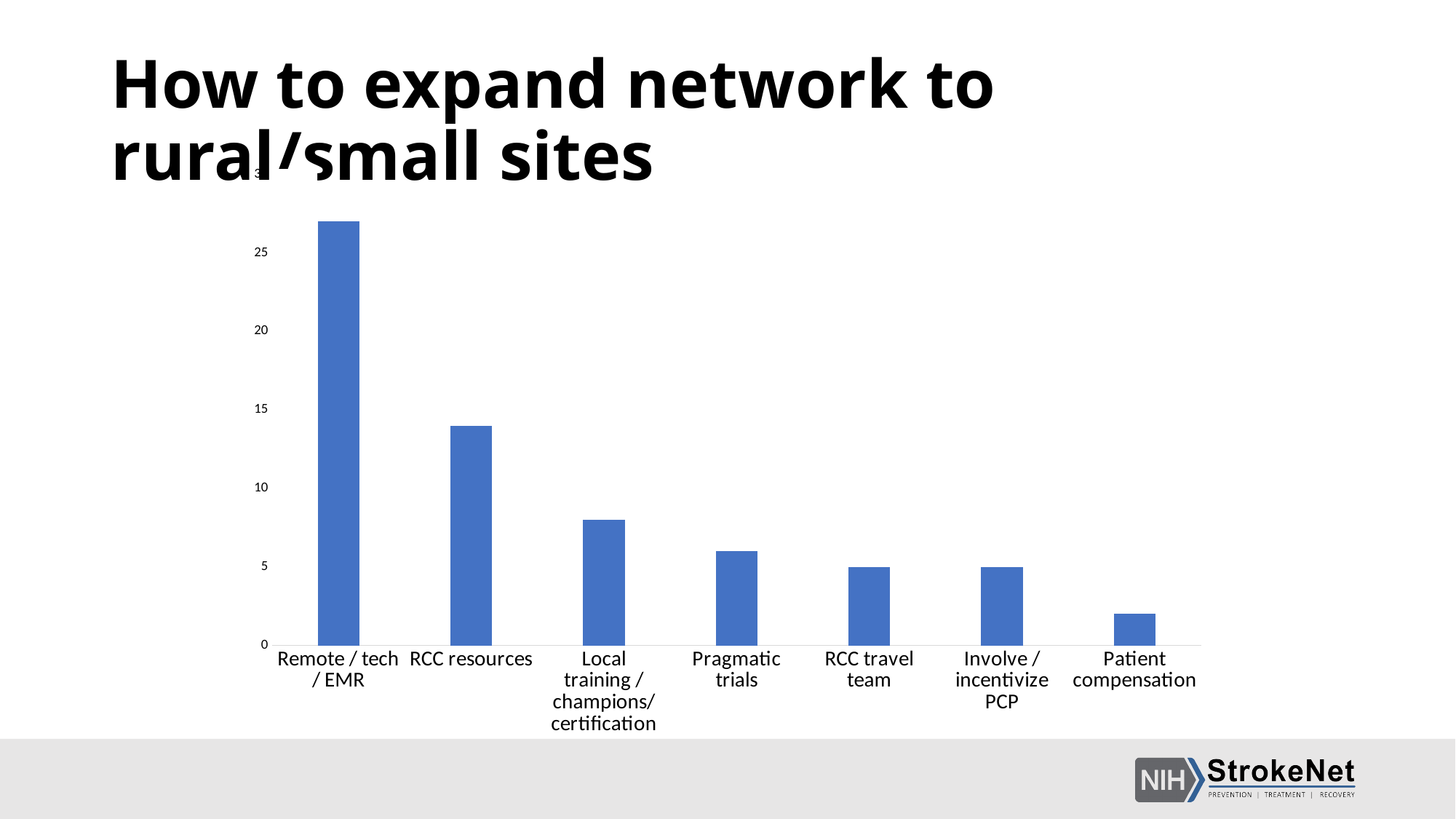
Is the value for Patient compensation greater or less than 5? less Do the bar values generally rise or fall from left to right along the x axis? fall What kind of chart is shown on the slide? bar chart How many categories are shown on the x axis of the chart? 7 Is the value for Remote / tech / EMR greater or less than 25? greater What is the title of the slide containing the chart? How to expand network to rural/small sites Which category has the highest bar? Remote / tech / EMR Which category has the lowest bar? Patient compensation Is the value for RCC resources greater or less than 15? less Which is larger, the value for RCC resources or the value for Pragmatic trials? RCC resources What colour are the bars in the chart? blue